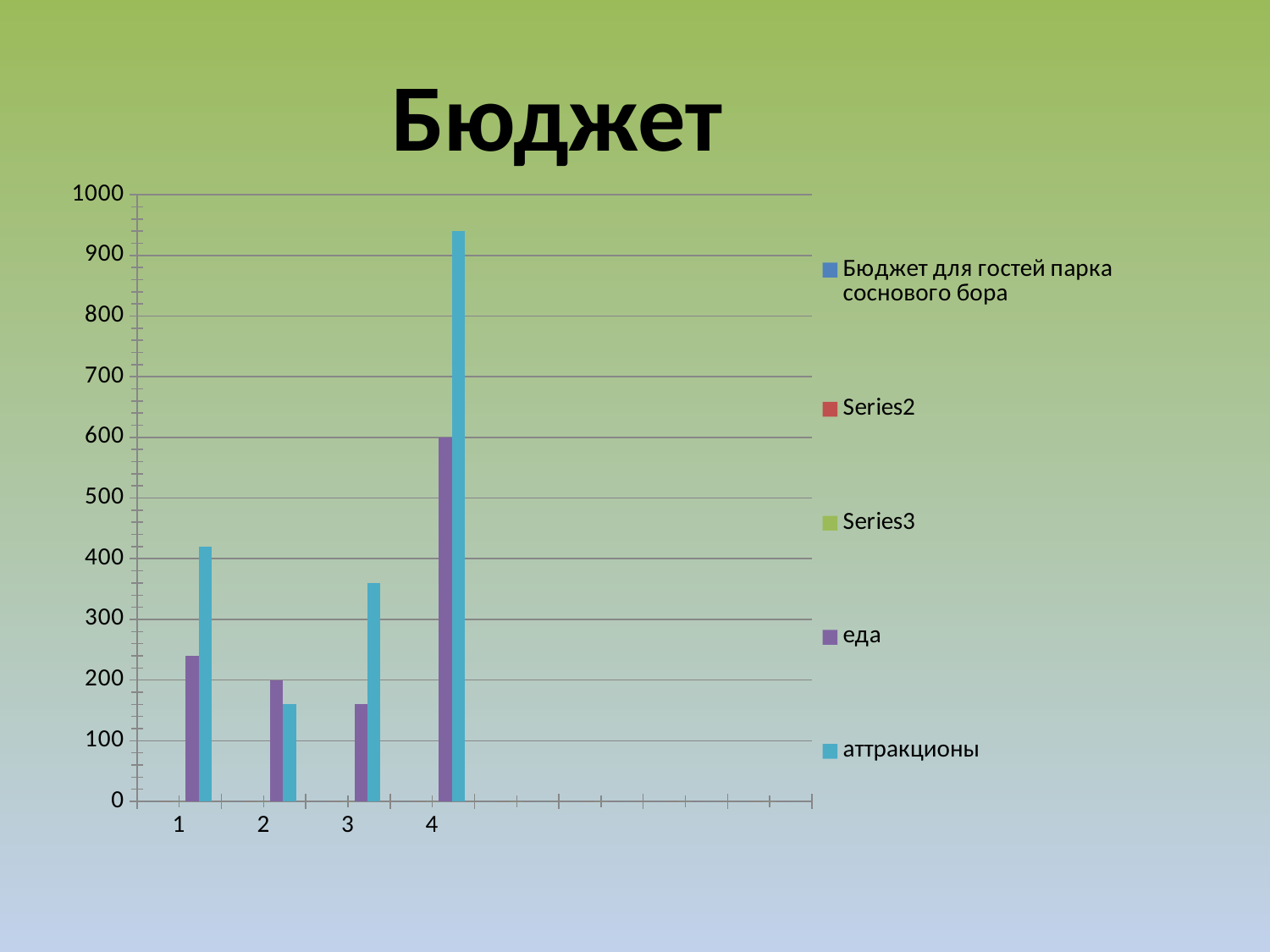
Is the value of аттракционы for category 4 greater or less than 900? greater What is the value of еда for category 4? 600 Which category has the highest value for аттракционы? 4 Is the value of аттракционы for category 1 greater or less than 400? greater Is the value of еда for category 3 greater or less than 200? less Which category has the lowest value for аттракционы? 2 How many series does the legend list? 5 What is the value of еда for category 2? 200 What is the title of the chart? Бюджет For category 2, which is larger: еда or аттракционы? еда How many categories are shown on the x axis? 4 What kind of chart is shown on the slide? bar chart